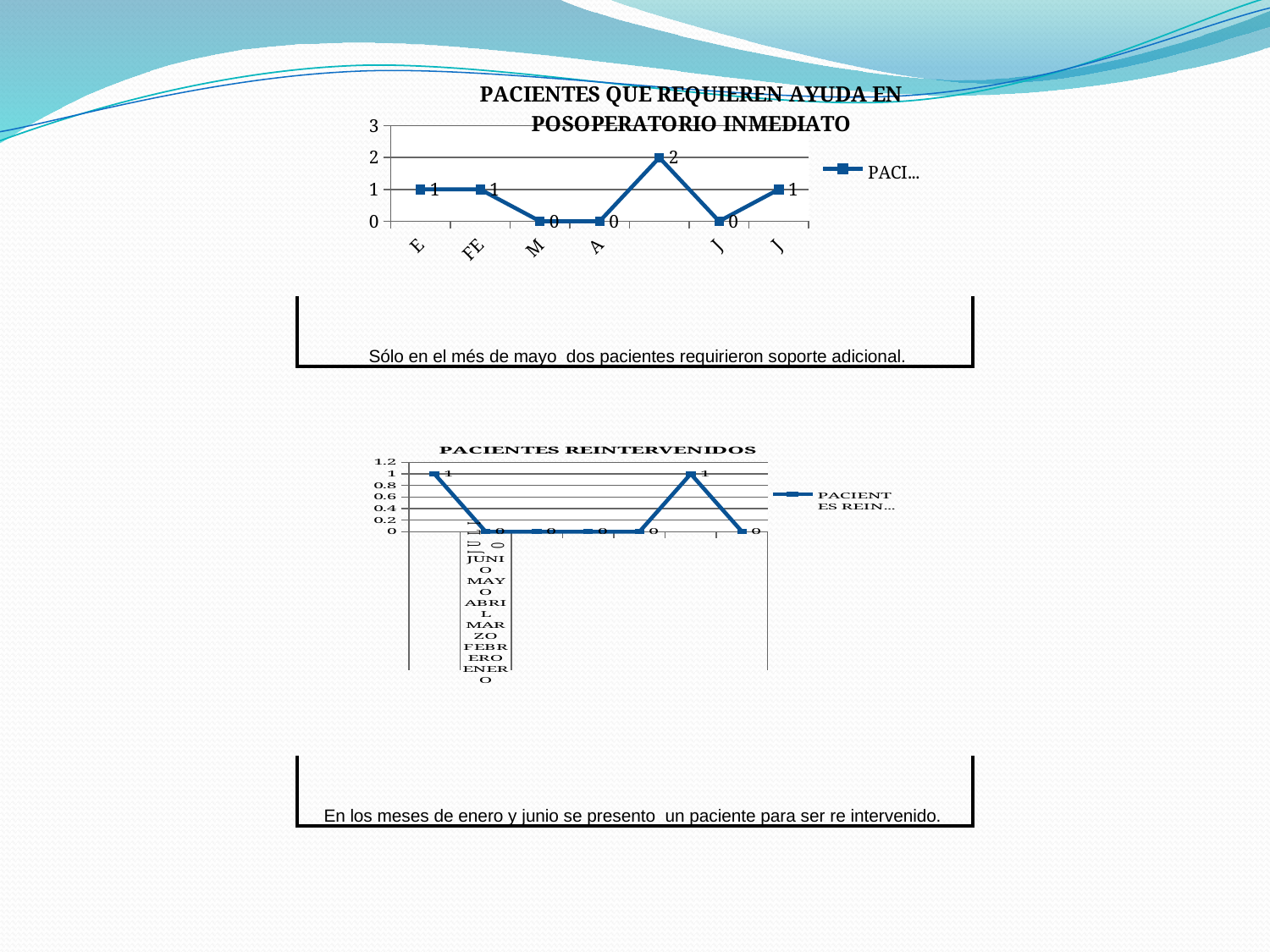
In the top chart, 'PACIENTES QUE REQUIEREN AYUDA EN POSOPERATORIO INMEDIATO', what is the value of the first point on the x axis? 1 How many data points are plotted in the top chart, 'PACIENTES QUE REQUIEREN AYUDA EN POSOPERATORIO INMEDIATO'? 7 How many series does the legend of the bottom chart, 'PACIENTES REINTERVENIDOS', list? 1 In the top chart, 'PACIENTES QUE REQUIEREN AYUDA EN POSOPERATORIO INMEDIATO', what is the highest value plotted? 2 How many data points are plotted in the bottom chart, 'PACIENTES REINTERVENIDOS'? 7 What kind of chart is the bottom chart, 'PACIENTES REINTERVENIDOS'? Line chart How many series does the legend of the top chart, 'PACIENTES QUE REQUIEREN AYUDA EN POSOPERATORIO INMEDIATO', list? 1 In the bottom chart, 'PACIENTES REINTERVENIDOS', how many points have a value of 1? 2 In the bottom chart, 'PACIENTES REINTERVENIDOS', what is the value of the last point on the x axis? 0 In the top chart, 'PACIENTES QUE REQUIEREN AYUDA EN POSOPERATORIO INMEDIATO', what is the difference between the highest and lowest plotted values? 2 What kind of chart is the top chart, 'PACIENTES QUE REQUIEREN AYUDA EN POSOPERATORIO INMEDIATO'? Line chart